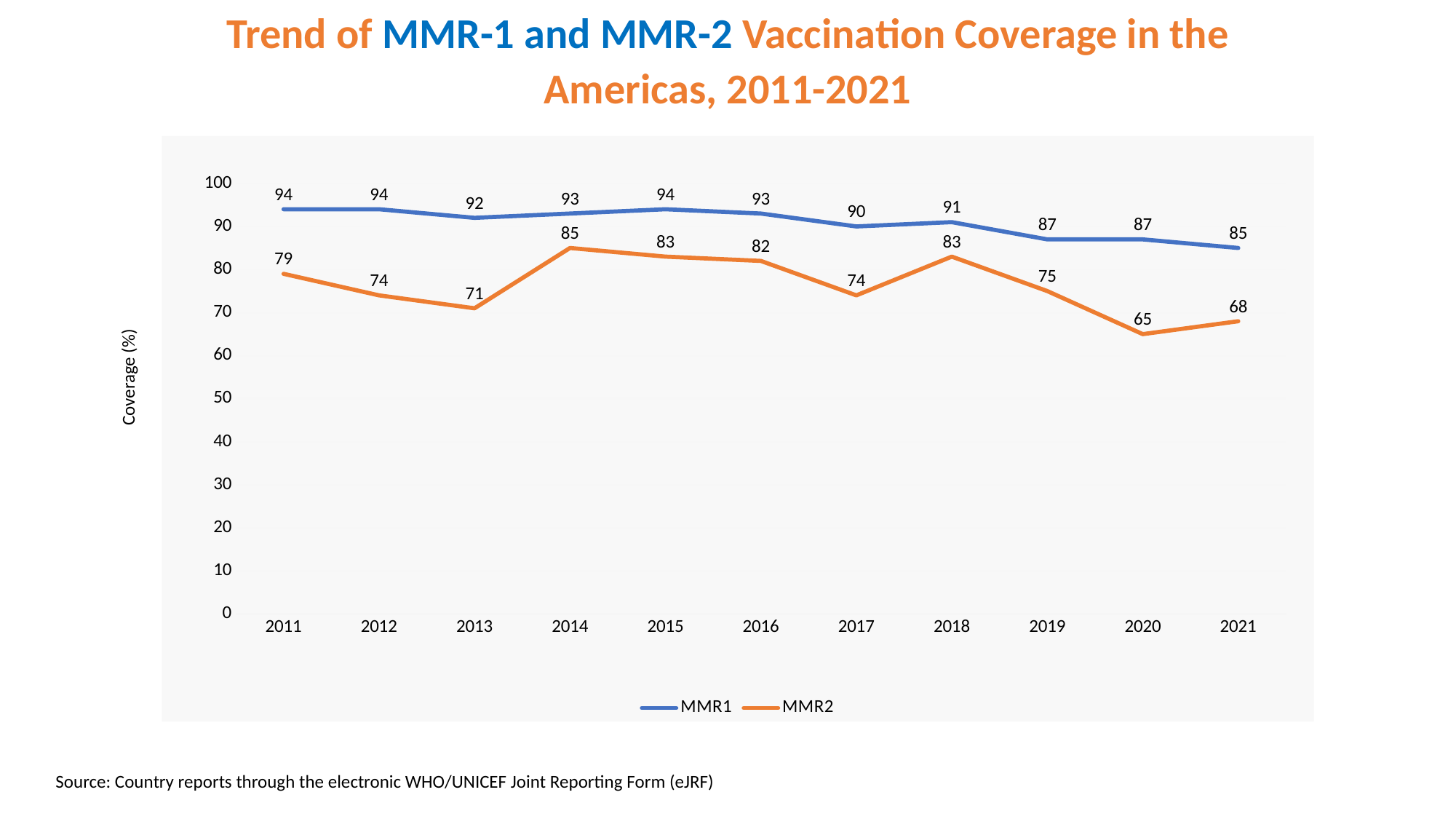
What kind of chart is shown on the slide? Line chart What is the MMR2 coverage value for 2020? 65 What is the MMR1 coverage value for 2017? 90 What is the MMR2 coverage value for 2014? 85 What is the difference between MMR2 coverage in 2014 and 2013? 14 How many series does the legend list? 2 In which year is the MMR2 coverage lowest? 2020 Which is larger, the MMR2 coverage in 2018 or in 2019? 2018 What is the difference between MMR1 and MMR2 coverage in 2021? 17 Does the MMR1 coverage rise or fall from 2018 to 2021? Fall In which year is the MMR1 coverage lowest? 2021 How many years are shown on the x axis? 11